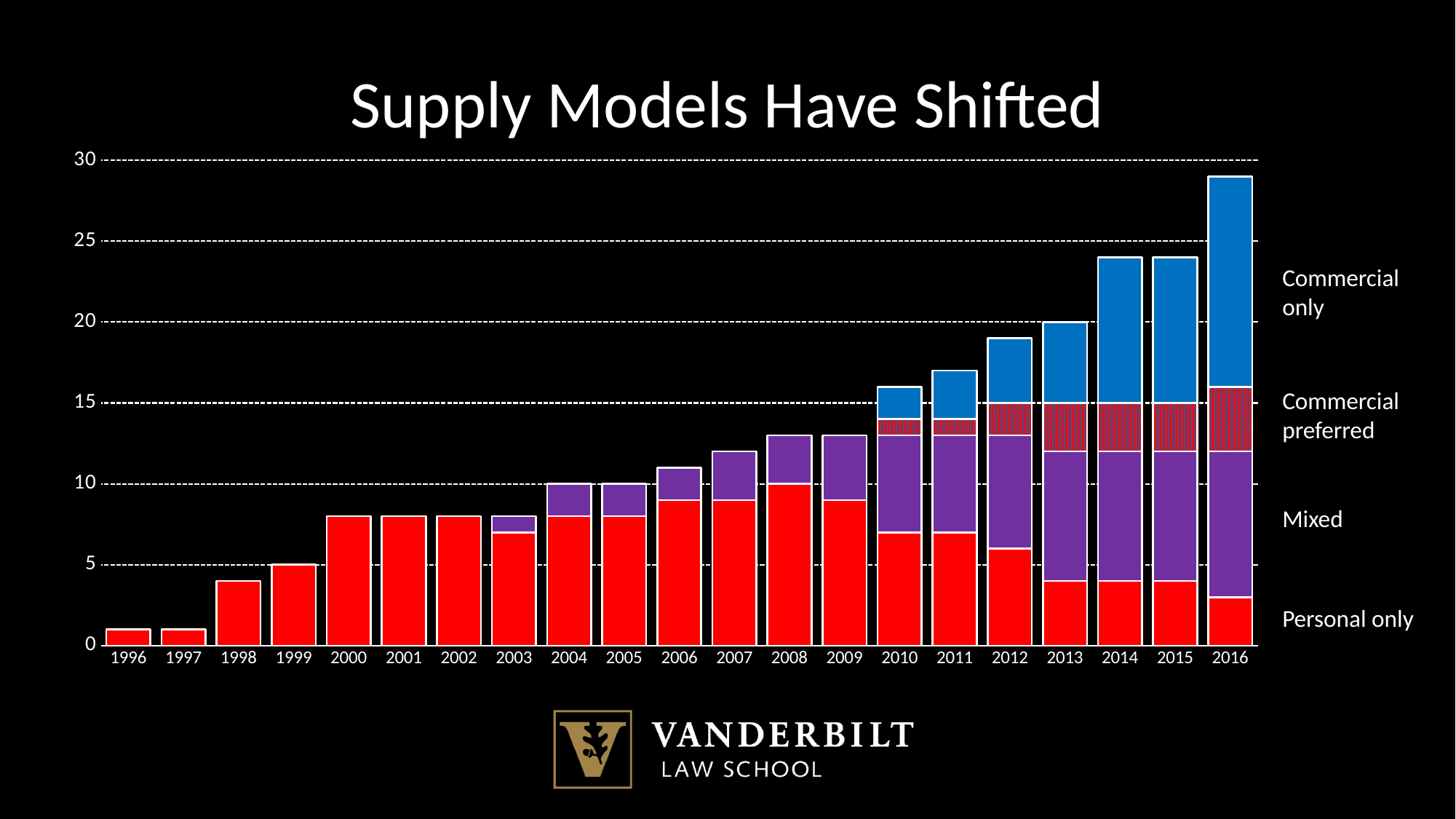
Is the total for 1996 greater or less than 5? less How many supply model categories are labelled on the right of the chart? 4 Which year has the tallest stacked bar? 2016 How many years are shown along the x axis of the chart? 21 What is the total height of the bar for 1999? 5 What kind of chart is shown on the slide? Stacked bar chart What is the total height of the stacked bar for 2013? 20 Is the total for 2012 greater or less than 20? less Do the total bar heights generally rise or fall from 1996 to 2016? Rise Which year has a taller total bar, 2008 or 2003? 2008 Is the total for 2016 greater or less than 25? greater What is the title of the chart? Supply Models Have Shifted